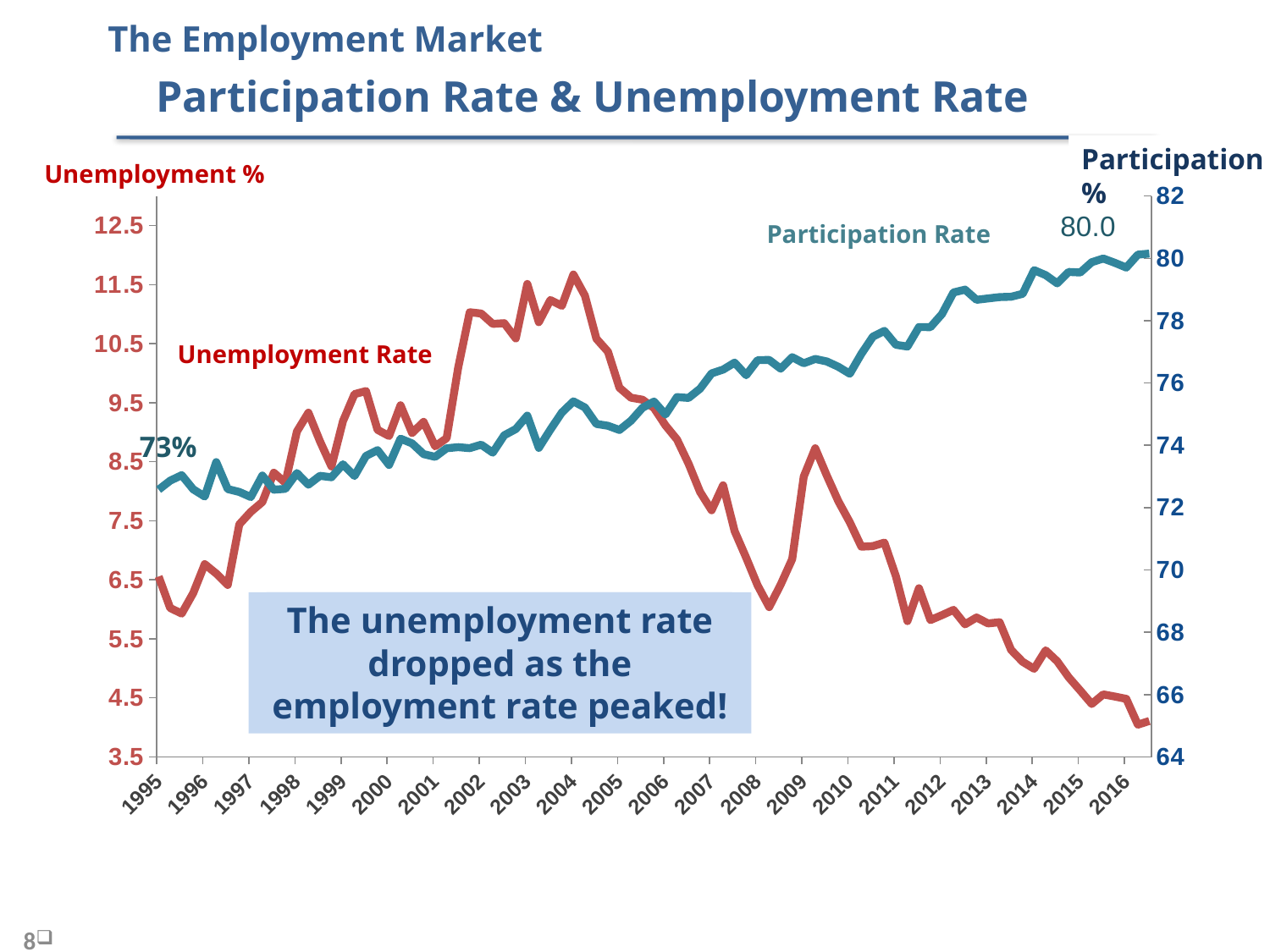
How many data series are plotted on the chart? 2 Does the unemployment rate rise or fall from 2004 to 2016? fall What is the label of the left vertical axis? Unemployment % What is the participation rate value labelled at the start of the series in 1995? 73% What kind of chart is shown on the slide? line chart Is the participation rate in 2013 greater or less than 78? greater By how many percentage points did the participation rate rise from its labelled 1995 value to its labelled 2016 value? 7 In which year does the unemployment rate reach its highest point? 2004 Does the participation rate generally rise or fall from 1995 to 2016? rise What is the participation rate value labelled at the end of the series in 2016? 80.0 Which is larger, the unemployment rate in 1995 or the unemployment rate in 2016? 1995 Is the unemployment rate at the end of 2016 greater or less than 4.5? less